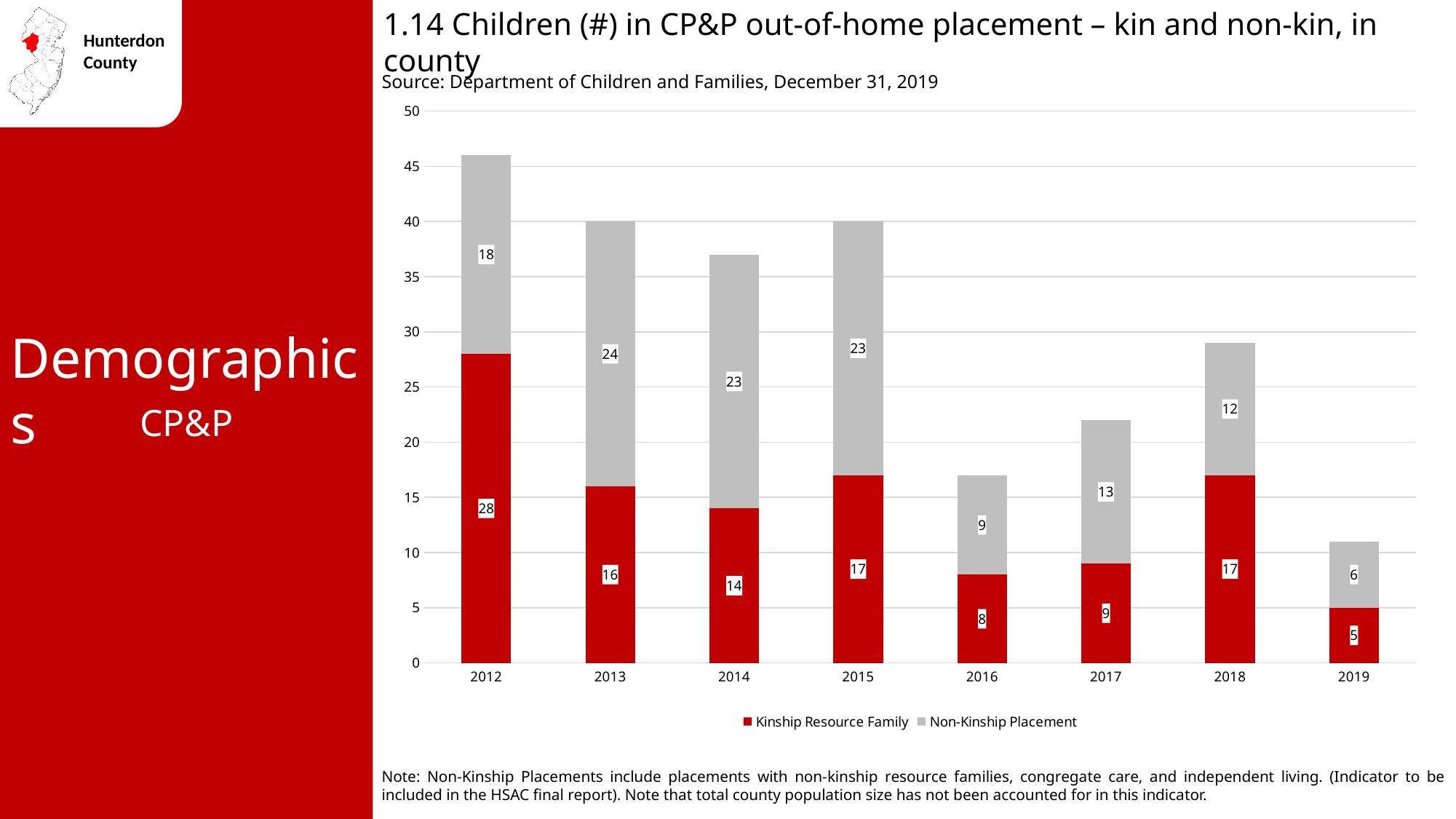
How many series does the legend list? 2 What is the Kinship Resource Family value for 2019? 5 What is the Non-Kinship Placement value for 2013? 24 What kind of chart is shown on the slide? Stacked bar chart What is the total of the stacked bar for 2016? 17 What is the difference between the Non-Kinship Placement value and the Kinship Resource Family value in 2014? 9 Which is larger in 2018, the Kinship Resource Family value or the Non-Kinship Placement value? Kinship Resource Family What is the Kinship Resource Family value for 2012? 28 What is the total of the stacked bar for 2012? 46 Which year has the lowest Non-Kinship Placement value? 2019 Which year has the highest Kinship Resource Family value? 2012 How many years are shown on the x axis? 8